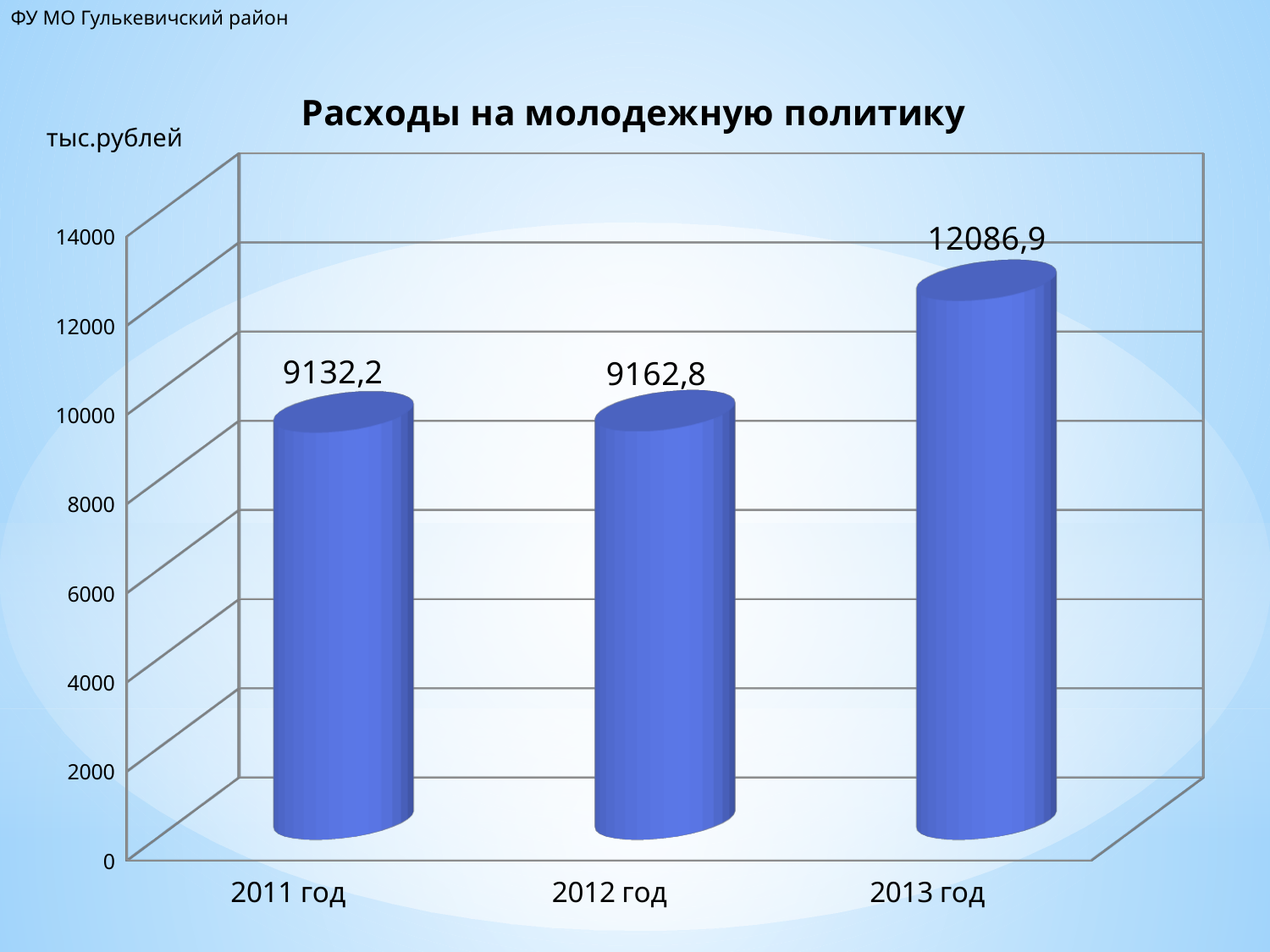
Which year has the highest expenditure? 2013 год What is the difference between the values for 2013 год and 2012 год? 2924,1 What is the value for 2013 год? 12086,9 How many years are shown on the chart? 3 What kind of chart is shown? bar chart Is the value for 2013 год greater or less than 12000? greater What is the value for 2011 год? 9132,2 Which is larger, the value for 2012 год or 2013 год? 2013 год What is the difference between the values for 2013 год and 2011 год? 2954,7 What is the title of the chart? Расходы на молодежную политику What is the value for 2012 год? 9162,8 Is the value for 2011 год greater or less than 10000? less